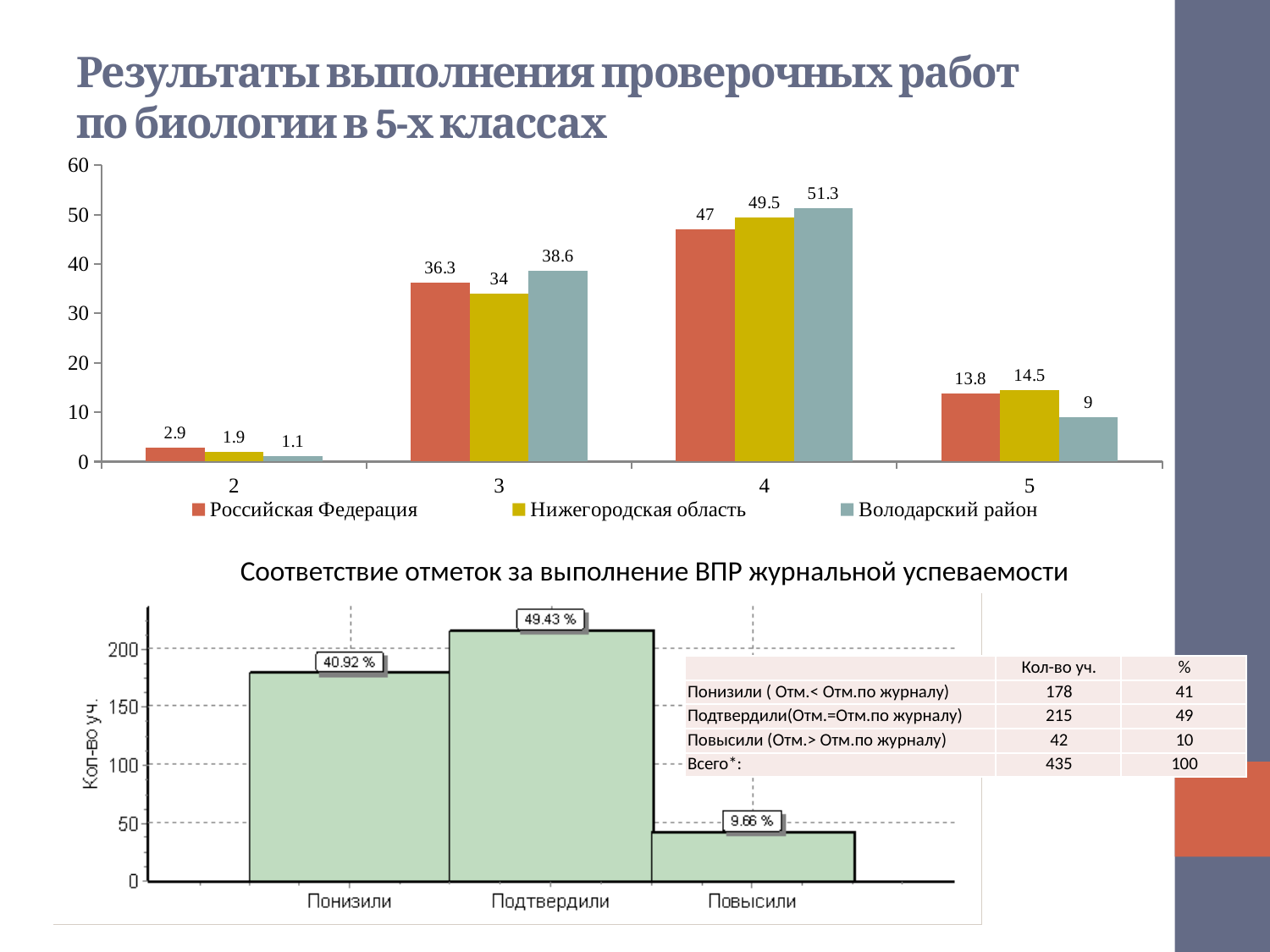
In the top chart, which category has the highest value for Российская Федерация? 4 How many categories are shown on the x axis of the top chart? 4 In the chart titled 'Соответствие отметок за выполнение ВПР журнальной успеваемости', which category has the lowest value? Повысили In the top chart, what is the value for Нижегородская область for category 5? 14.5 What kind of chart is the chart titled 'Соответствие отметок за выполнение ВПР журнальной успеваемости'? Bar chart In the top chart, which category has the lowest value for Володарский район? 2 In the top chart, what is the difference between Володарский район and Нижегородская область for category 3? 4.6 In the top chart, for category 5, which is larger: Российская Федерация or Володарский район? Российская Федерация In the top chart, what is the value for Володарский район for category 4? 51.3 In the top chart, what is the value for Российская Федерация for category 3? 36.3 In the chart titled 'Соответствие отметок за выполнение ВПР журнальной успеваемости', what percentage is shown for Подтвердили? 49.43 % How many series does the legend of the top chart list? 3